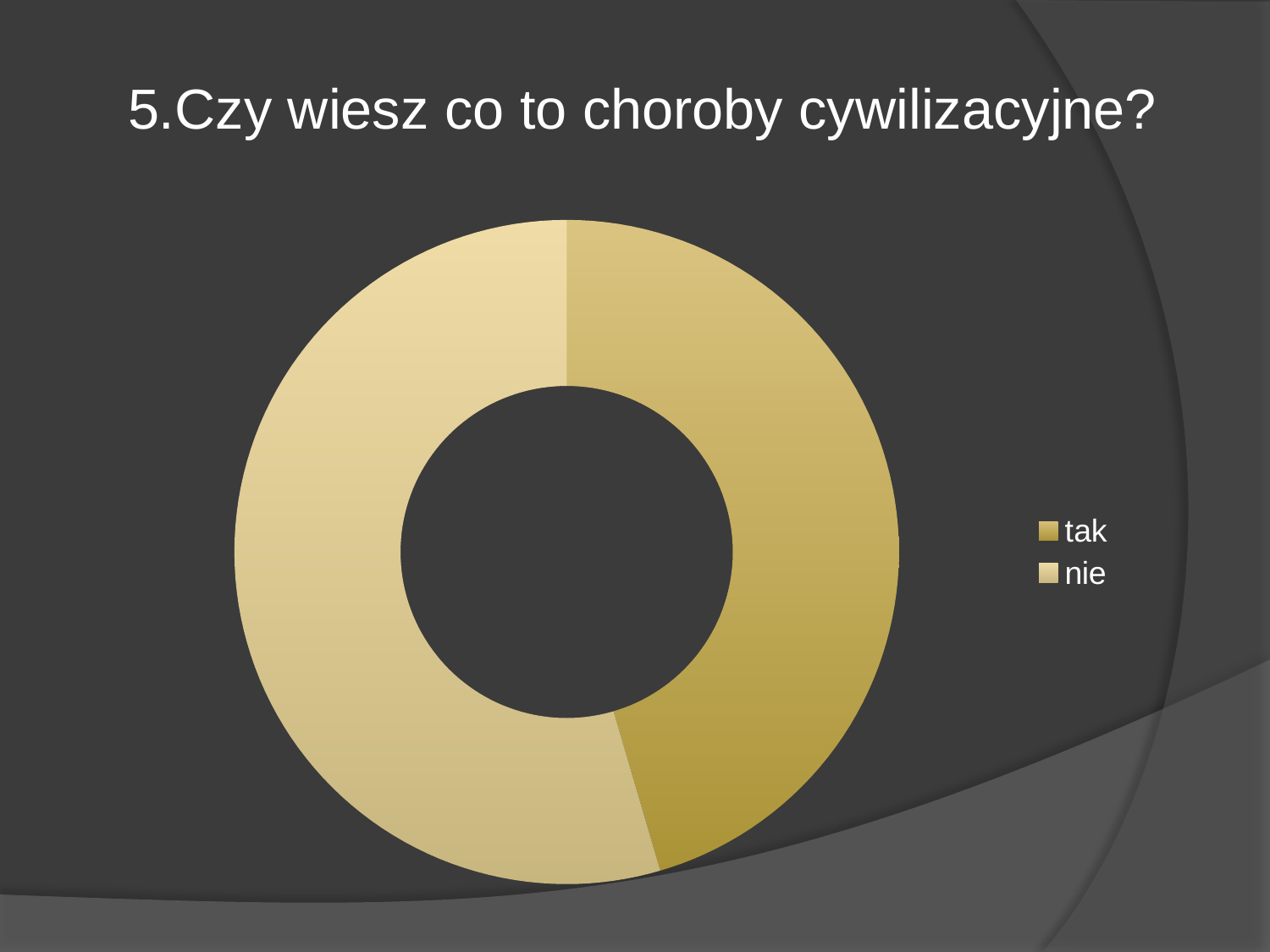
Which category has the smallest share of the chart? tak How many categories does the chart show? 2 Which is larger, the share for "tak" or the share for "nie"? nie What are the legend entries of the chart? tak, nie What is the title of the chart on the slide? 5.Czy wiesz co to choroby cywilizacyjne? What kind of chart is shown on the slide? doughnut chart Which category has the largest share of the chart? nie How many entries does the legend list? 2